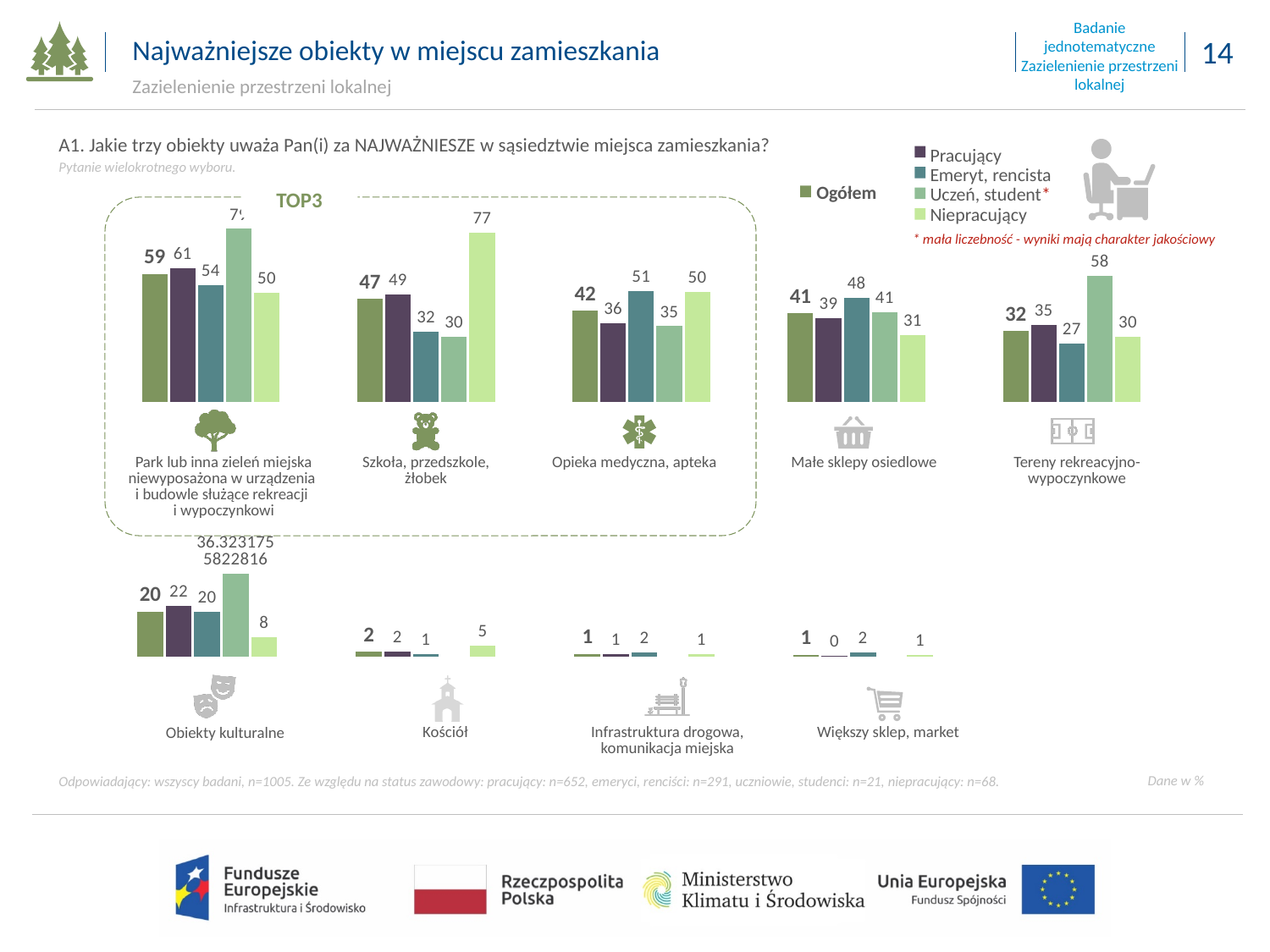
In the chart for 'Kościół', what is the difference between the Niepracujący value and the Ogółem value? 3 In the chart for 'Opieka medyczna, apteka', what is the value for Ogółem? 42 In the chart for 'Tereny rekreacyjno-wypoczynkowe', which group has the highest value? Uczeń, student In the chart for 'Większy sklep, market', what is the value for Pracujący? 0 What kind of chart is used for 'Małe sklepy osiedlowe'? Bar chart In the chart for 'Park lub inna zieleń miejska', which is larger: the value for Pracujący or the value for Niepracujący? Pracujący How many series does the legend list? 5 In the chart for 'Szkoła, przedszkole, żłobek', what is the value for Niepracujący? 77 In the chart for 'Małe sklepy osiedlowe', what is the value for Emeryt, rencista? 48 In the chart for 'Obiekty kulturalne', what is the value for Niepracujący? 8 In the chart for 'Szkoła, przedszkole, żłobek', which group has the lowest value? Uczeń, student In the chart for 'Opieka medyczna, apteka', what is the difference between the Emeryt, rencista value and the Pracujący value? 15